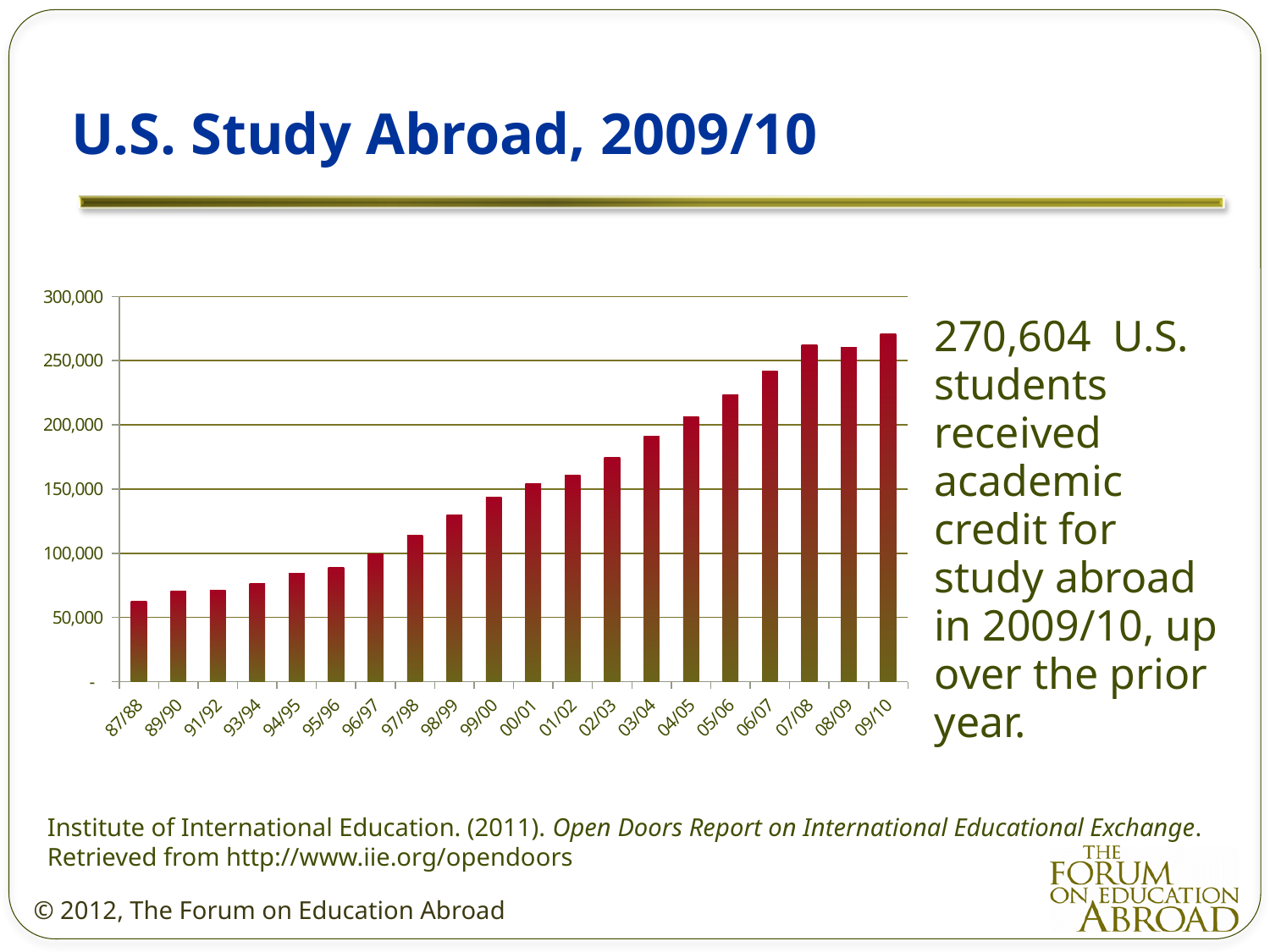
Is the value for 07/08 greater or less than 250,000? greater Which academic year has the lowest bar in the chart? 87/88 Is the value for 99/00 greater or less than 150,000? less According to the slide, how many U.S. students received academic credit for study abroad in 2009/10? 270,604 Is the value for 87/88 greater or less than 100,000? less How many academic years are plotted on the x axis of the chart? 20 Do the values generally rise or fall from 87/88 to 09/10? rise What kind of chart is shown on the slide? bar chart What is the title of the slide containing the chart? U.S. Study Abroad, 2009/10 Which academic year has the highest bar in the chart? 09/10 Which is larger, the value for 05/06 or the value for 06/07? 06/07